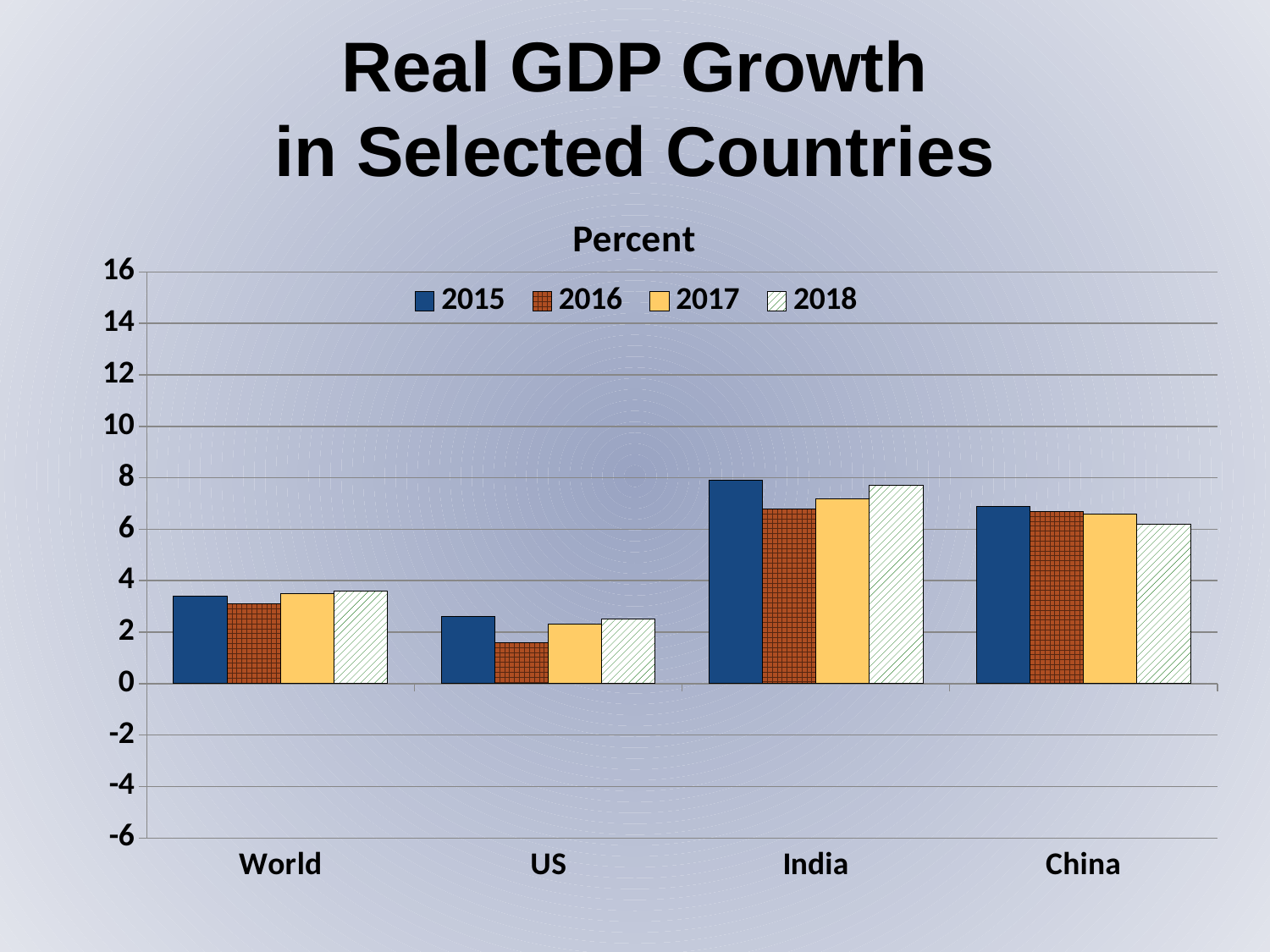
Which country or region has the lowest real GDP growth in 2016? US How many series does the legend list? 4 Which is larger, the 2015 value for India or the 2015 value for China? India How many countries/regions are shown on the x axis? 4 Is the 2018 value for China greater or less than 8? less Is the 2016 value for US greater or less than 2? less What are the four years listed in the legend? 2015, 2016, 2017, 2018 Is the 2015 value for India greater or less than 6? greater Which country or region has the highest real GDP growth in 2015? India Which is larger, the 2016 value for World or the 2016 value for US? World What kind of chart is shown on the slide? bar chart Do the values for China rise or fall from 2015 to 2018? fall